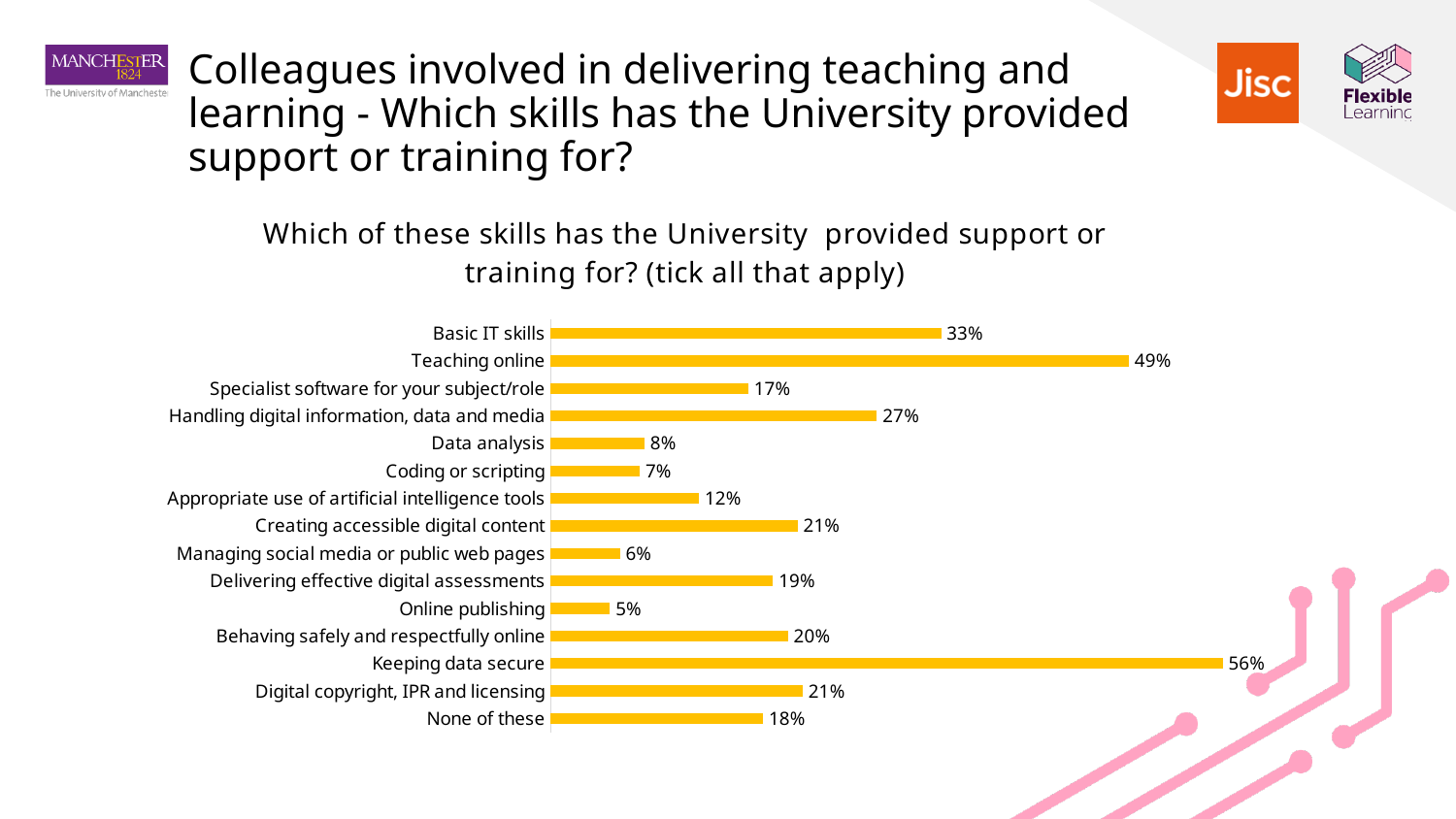
What colour are the bars in the chart? Yellow What is the value for Keeping data secure? 56% What percentage of colleagues said the University provided support or training for Teaching online? 49% Which is larger, the value for Handling digital information, data and media or the value for Creating accessible digital content? Handling digital information, data and media What is the value for None of these? 18% What is the difference between the values for Keeping data secure and Teaching online? 7% What kind of chart is shown on the slide? Bar chart What is the difference between Basic IT skills and Data analysis? 25% How many skill categories are shown in the chart? 15 Which skill has the lowest percentage? Online publishing Which skill has the highest percentage? Keeping data secure What percentage is shown for Appropriate use of artificial intelligence tools? 12%